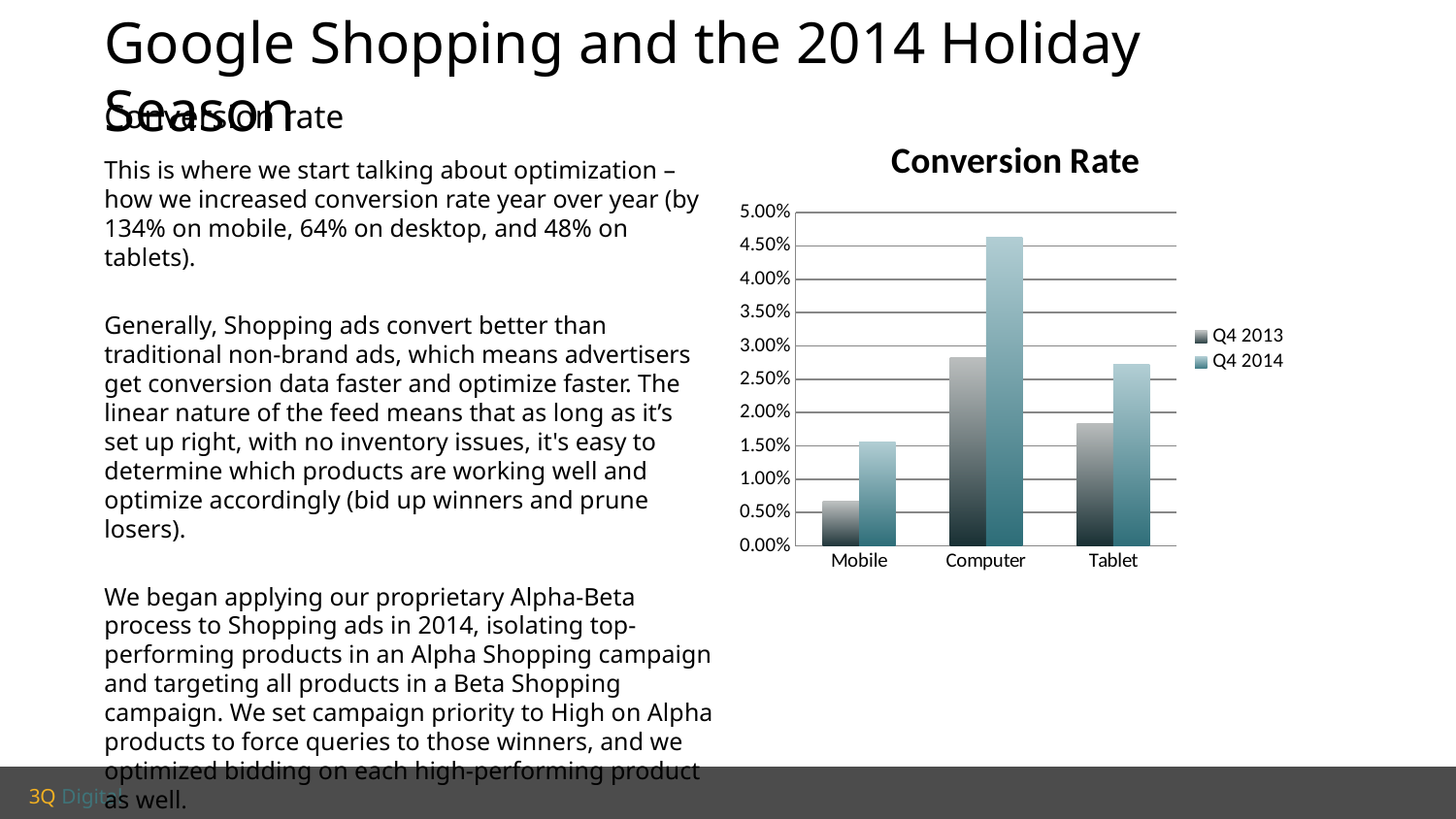
How many device categories are shown on the x axis of the chart? 3 How many series does the chart's legend list? 2 Is the Q4 2014 conversion rate for Tablet greater or less than 2.50%? greater Which category has the lowest Q4 2013 conversion rate? Mobile Is the Q4 2013 conversion rate for Computer greater or less than 3.00%? less Which category has the highest Q4 2014 conversion rate? Computer For Tablet, which series has the larger conversion rate, Q4 2013 or Q4 2014? Q4 2014 What type of chart is shown on the slide? bar chart What is the title of the chart? Conversion Rate Which series are listed in the chart's legend? Q4 2013 and Q4 2014 Is the Q4 2014 conversion rate for Computer greater or less than 4.00%? greater